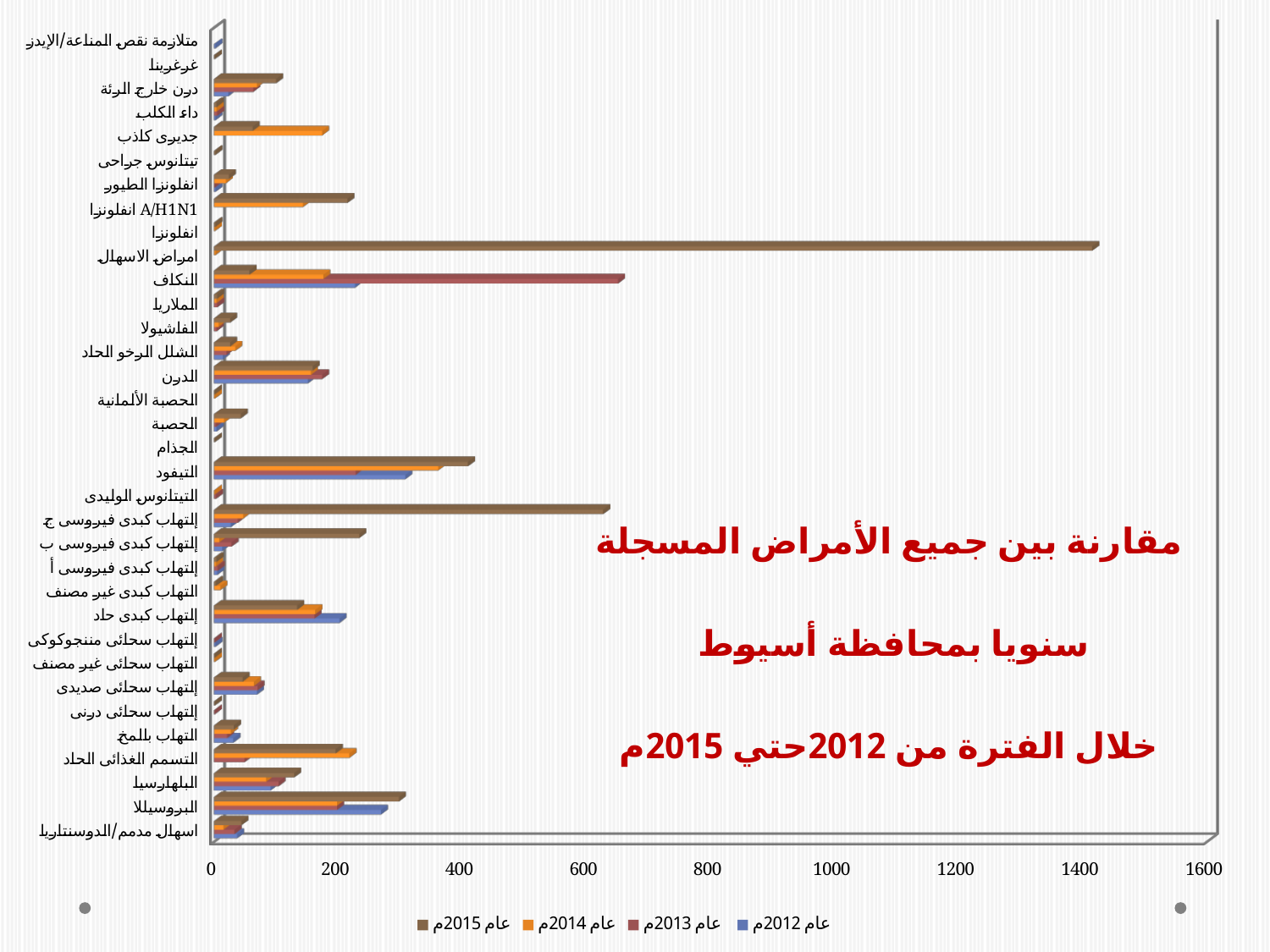
Is the value for امراض الاسهال in عام 2015م greater or less than 1200? greater Which is larger in عام 2015م: البروسيلا or البلهارسيا? البروسيلا Which disease category has the longest bar in the chart? امراض الاسهال Is the value for التيفود in عام 2015م greater or less than 200? greater Is the value for البروسيلا in عام 2015م greater or less than 200? greater What kind of chart is shown on the slide? bar chart How many series does the legend list? 4 What is the maximum value shown on the horizontal axis? 1600 Which is larger: النكاف in عام 2013م or التيفود in عام 2015م? النكاف in عام 2013م Which years are listed in the chart legend? عام 2012م, عام 2013م, عام 2014م, عام 2015م